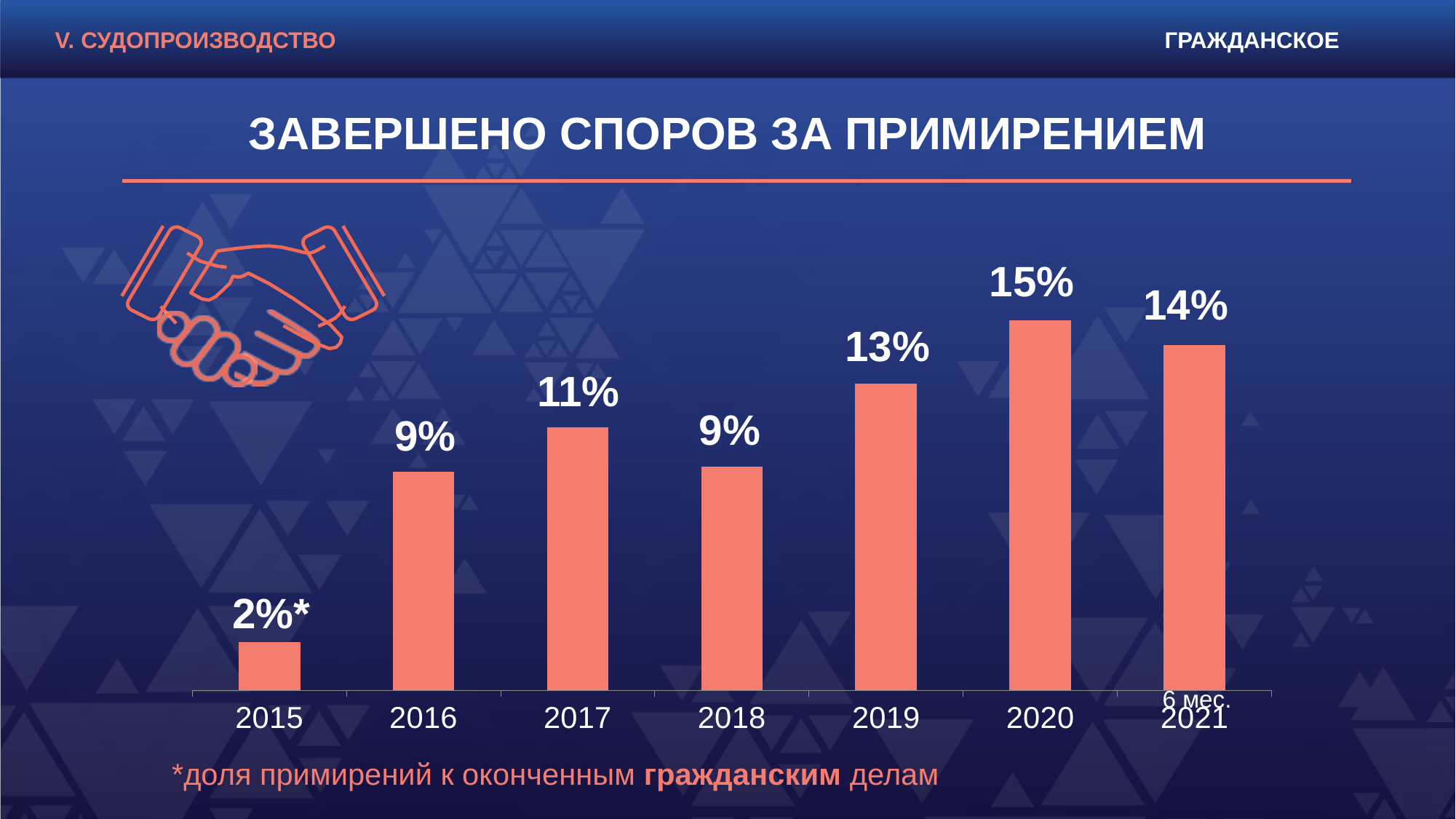
What is the value for 2020? 15% What is the title of the chart? ЗАВЕРШЕНО СПОРОВ ЗА ПРИМИРЕНИЕМ What is the value for 6 months of 2021? 14% Which year has the lowest value? 2015 What kind of chart is shown on the slide? Bar chart What is the difference between the values for 2020 and 2019? 2% What is the value for 2017? 11% What is the difference between the values for 2016 and 2015? 7% Which is larger, the value for 2017 or the value for 2018? 2017 How many years (categories) are shown on the chart? 7 What is the value for 2015? 2% Which year has the highest value? 2020